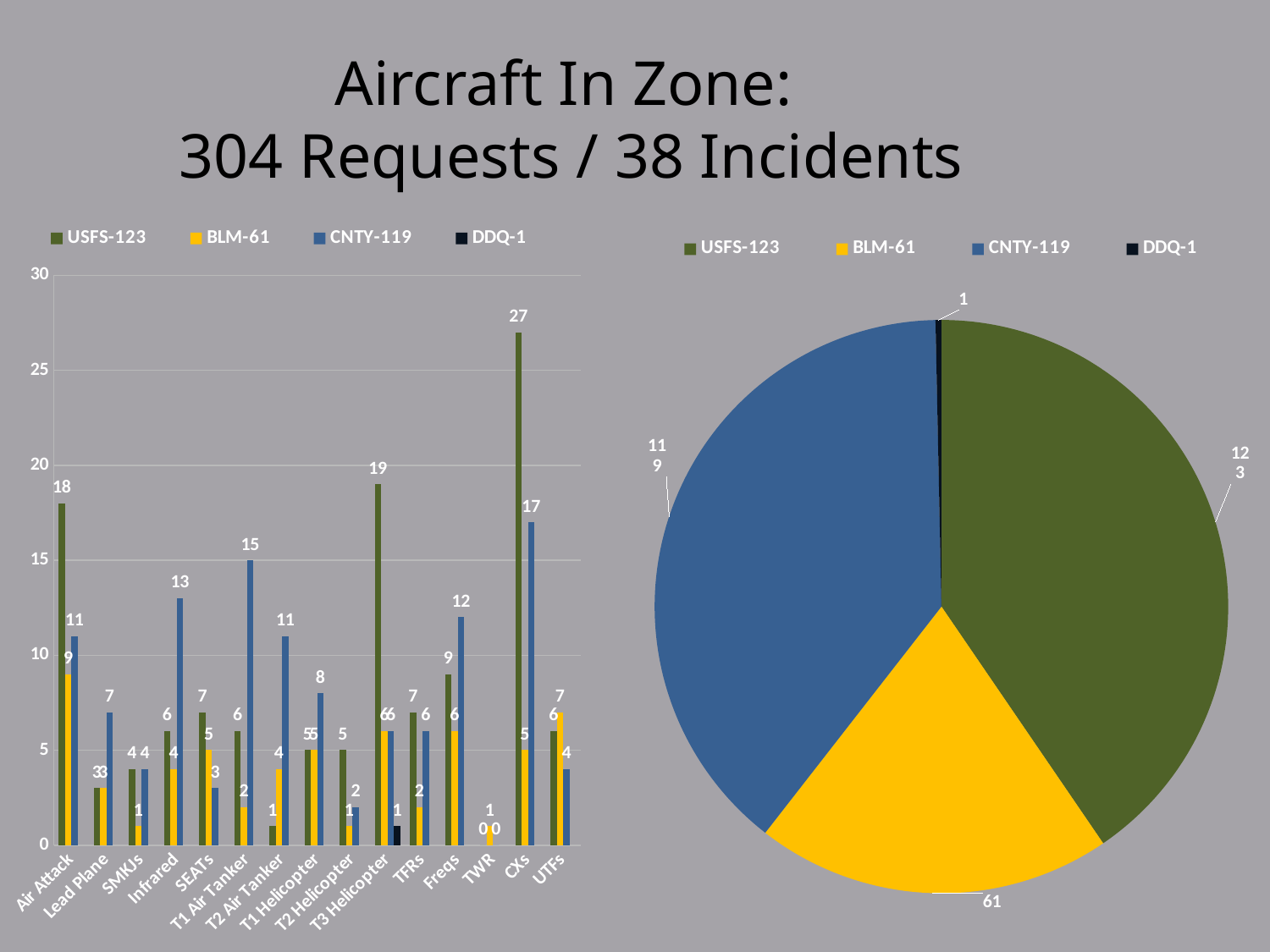
In the bar chart, what is the BLM-61 value for Air Attack? 9 In the bar chart, what is the USFS-123 value for CXs? 27 In the bar chart, which category has the highest USFS-123 value? CXs In the bar chart, what is the CNTY-119 value for T1 Air Tanker? 15 What type of chart is on the right side of the slide? pie chart What type of chart is on the left side of the slide? bar chart In the pie chart, which series has the smallest slice? DDQ-1 In the pie chart, what is the value of the BLM-61 slice? 61 How many categories are shown on the x axis of the bar chart? 15 In the bar chart, what is the difference between the USFS-123 and CNTY-119 values for CXs? 10 How many series does the legend of the bar chart list? 4 In the bar chart, which is larger for Infrared: the USFS-123 value or the CNTY-119 value? CNTY-119